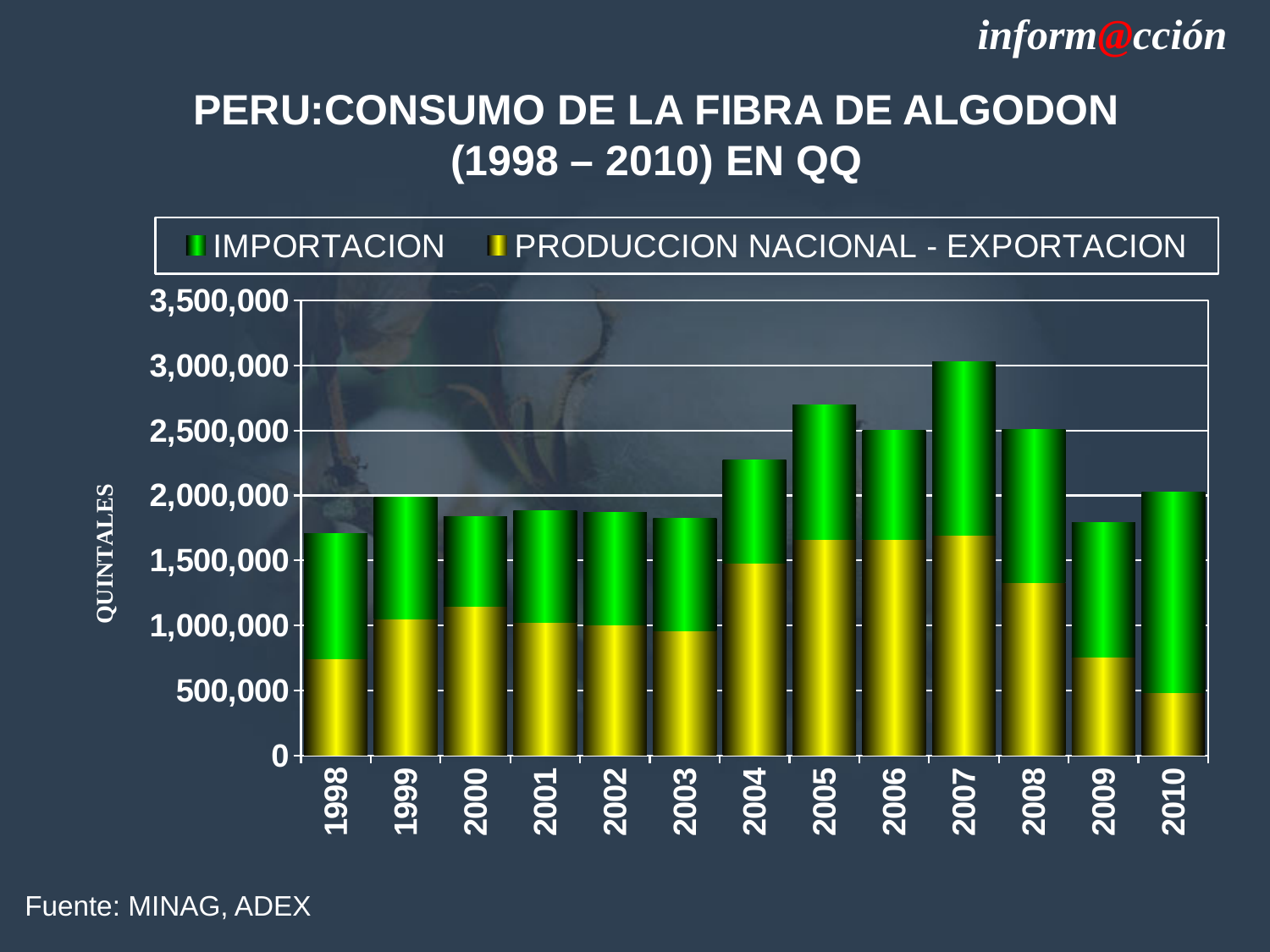
Is the PRODUCCION NACIONAL - EXPORTACION value for 2005 greater or less than 1,500,000? greater Is the total bar for 1998 greater or less than 2,000,000? less What is the label on the vertical axis of the chart? QUINTALES Which year has the highest total bar in the chart? 2007 Which series is shown in green in the chart? IMPORTACION Which year has the larger total bar, 2007 or 2009? 2007 Is the total bar for 2007 greater or less than 2,500,000? greater How many years are shown along the x axis of the chart? 13 What kind of chart is shown on the slide? Stacked bar chart Which year has the lowest PRODUCCION NACIONAL - EXPORTACION segment? 2010 How many series does the chart's legend list? 2